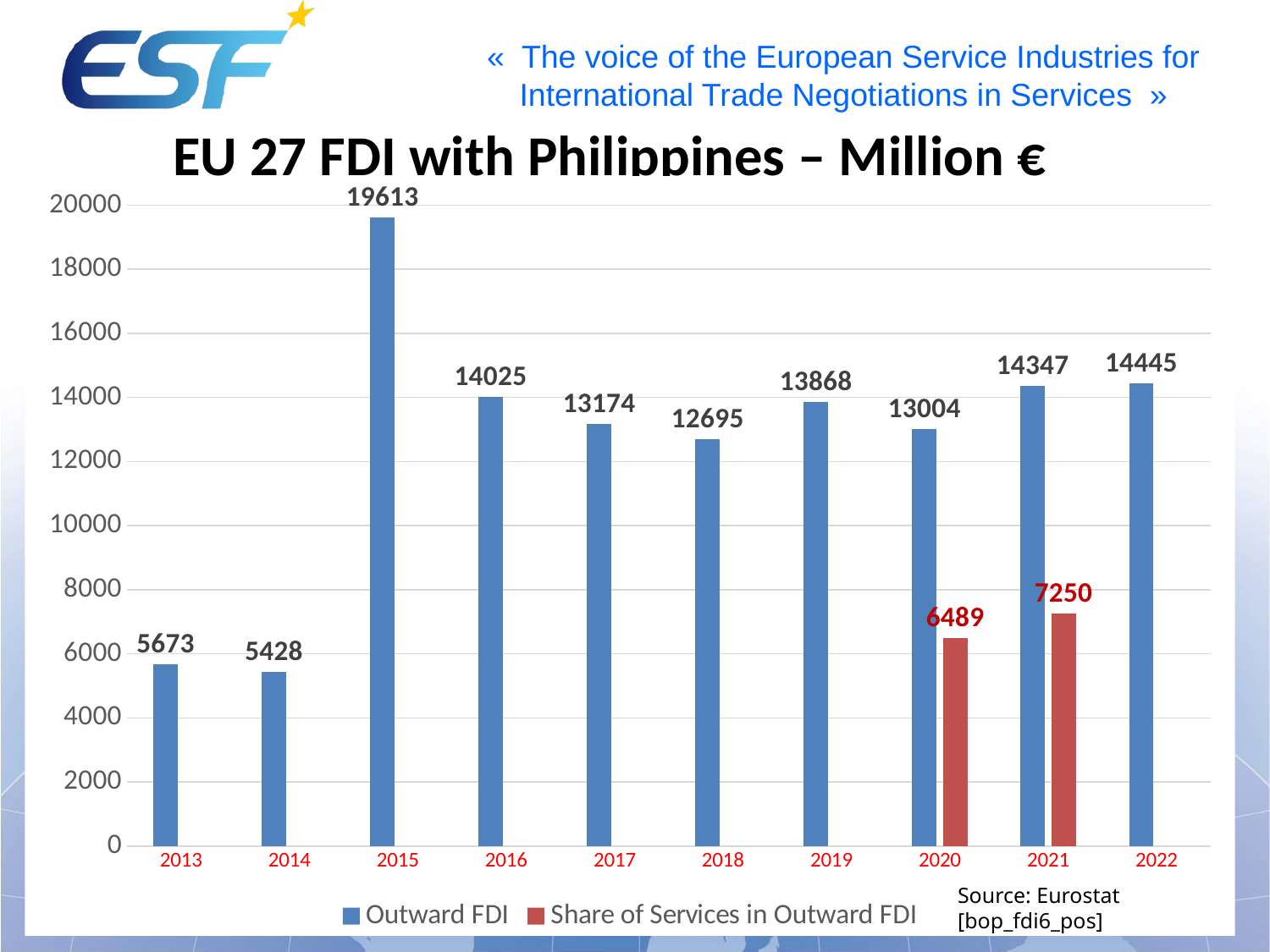
What is the difference between the Outward FDI values for 2022 and 2021? 98 Which year has the highest Outward FDI value? 2015 How many years are shown on the x axis? 10 Is the Outward FDI value for 2018 greater or less than 12000? greater Which is larger, the Outward FDI value for 2016 or for 2019? 2016 What kind of chart is shown on the slide? Bar chart How many series does the legend list? 2 Did the Outward FDI value rise or fall from 2013 to 2014? Fall Which year has the lowest Outward FDI value? 2014 What is the Share of Services in Outward FDI value for 2021? 7250 What is the source cited for the chart data? Eurostat [bop_fdi6_pos] What is the Outward FDI value for 2015? 19613